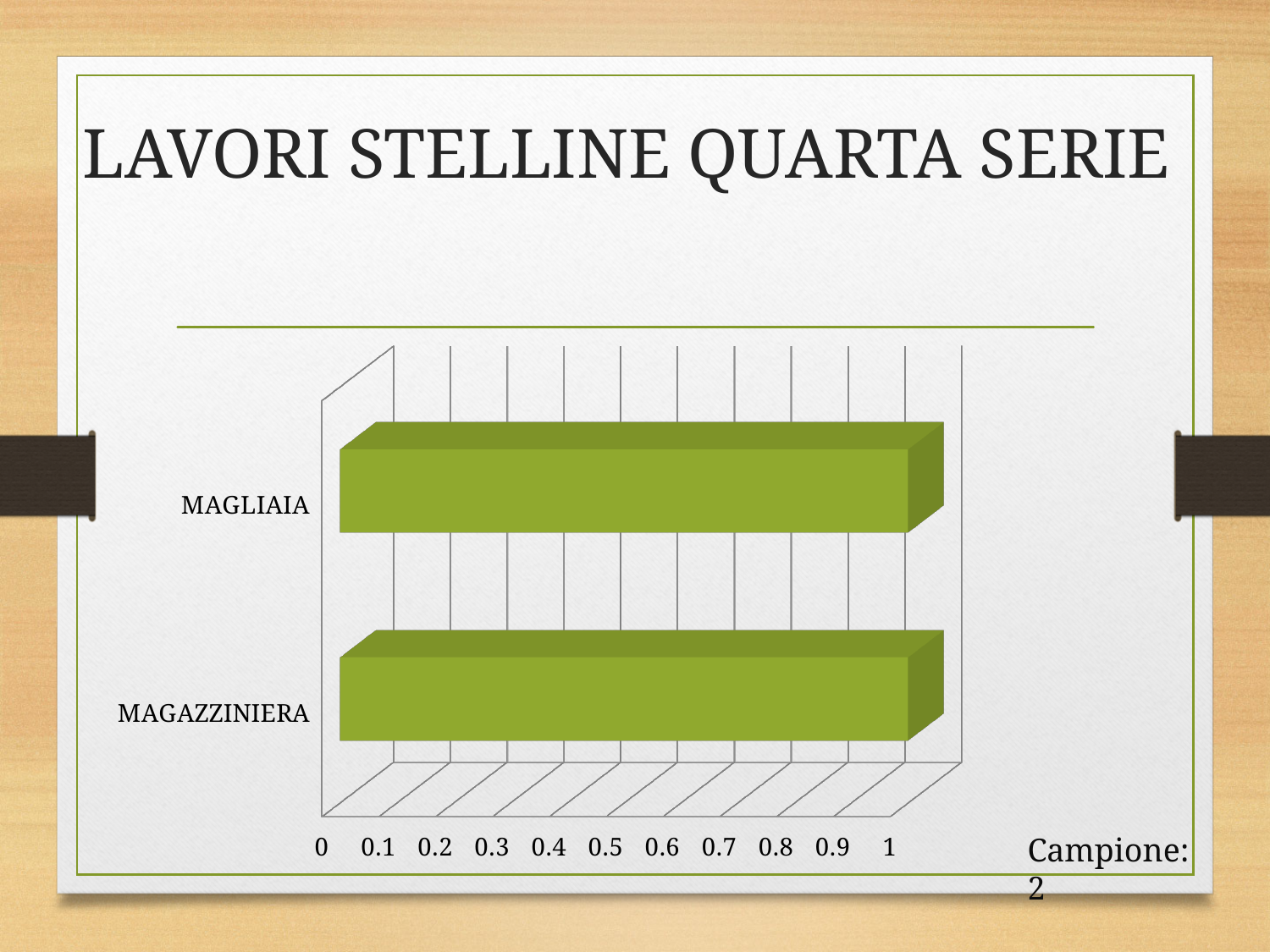
How many categories are plotted in the chart? 2 Is the value for MAGLIAIA greater or less than 0.5? greater Which category is listed at the top of the chart? MAGLIAIA Is the value for MAGAZZINIERA greater or less than 0.5? greater What sample size (Campione) is noted on the slide? 2 Is the value for MAGAZZINIERA greater or less than 0.3? greater What is the highest value shown on the horizontal axis of the chart? 1 What kind of chart is shown on the slide? bar chart